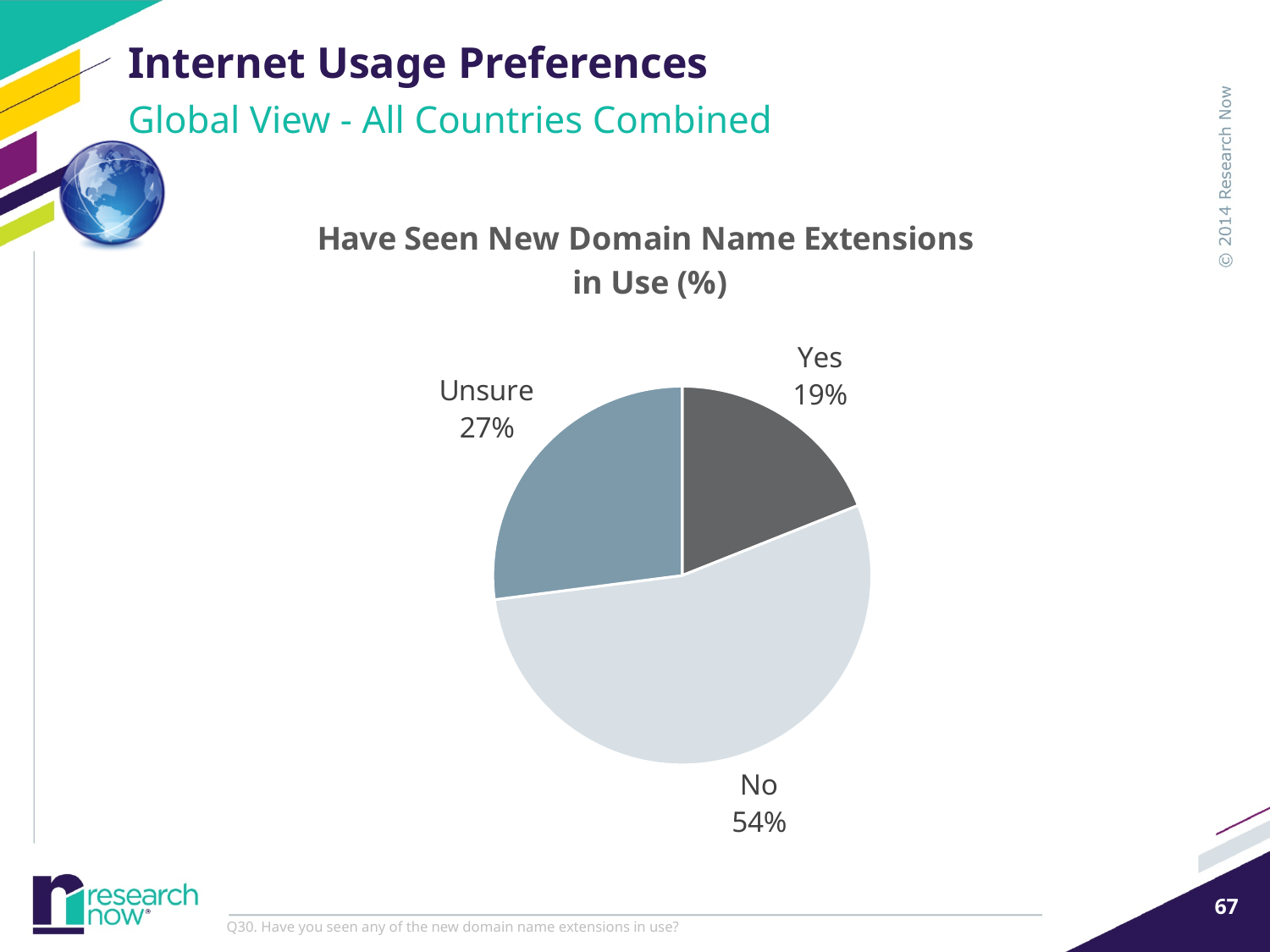
What percentage of respondents answered "Yes"? 19% Which response has the largest share of the pie? No What percentage of respondents answered "No"? 54% What is the difference in percentage points between "Unsure" and "Yes"? 8 What share of the pie does the "No" slice represent? 54% What is the difference in percentage points between "No" and "Yes"? 35 What percentage of respondents answered "Unsure"? 27% What is the title of the chart? Have Seen New Domain Name Extensions in Use (%) Which is larger, the share for "Unsure" or the share for "Yes"? Unsure Which response has the smallest share of the pie? Yes What kind of chart is shown on the slide? pie chart How many slices does the pie chart have? 3